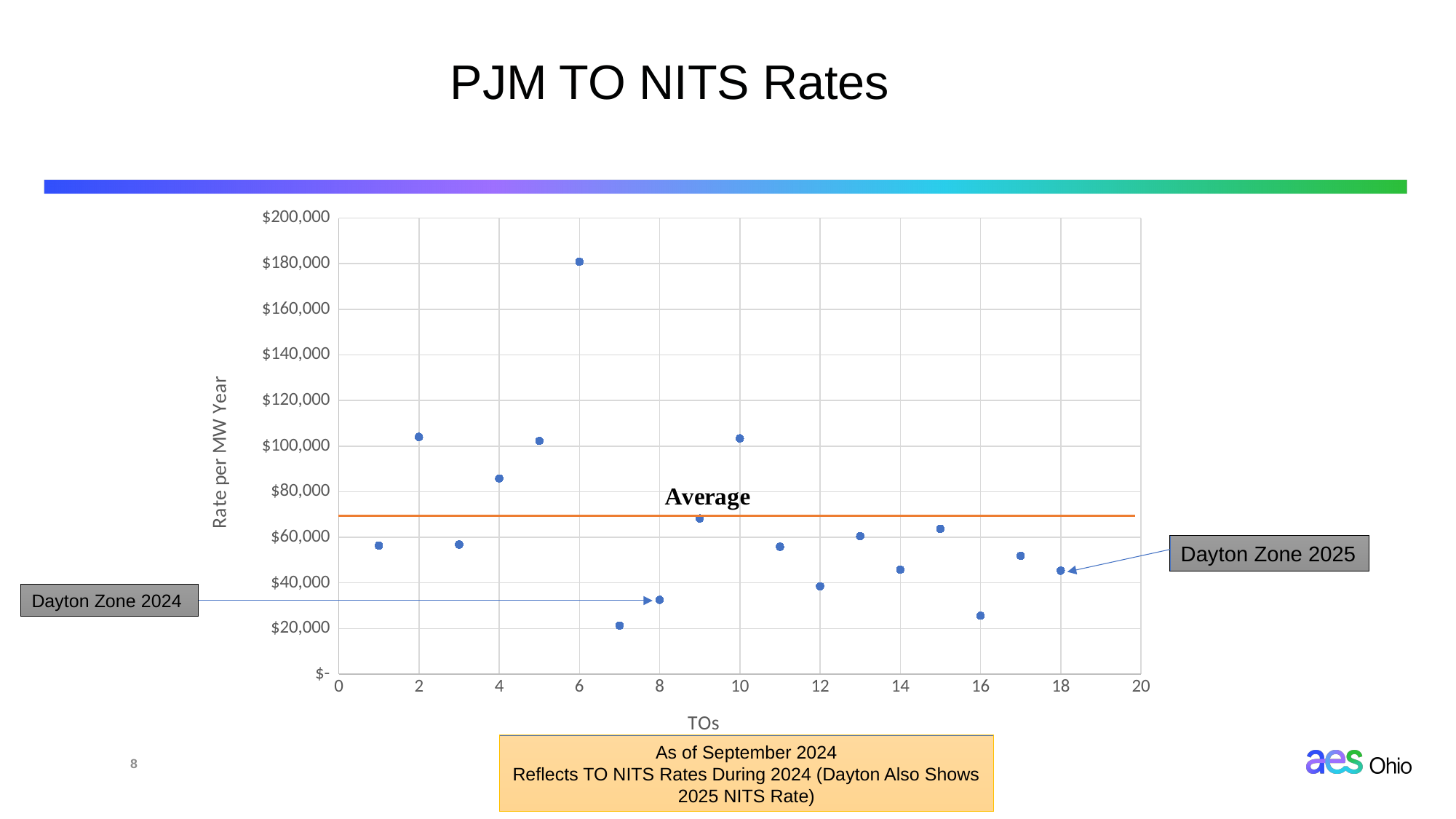
How many data points are plotted on the chart? 18 Which is larger, the value for TO 6 or the value for TO 10? TO 6 Is the value for TO 4 greater or less than $80,000? greater Is the Dayton Zone 2024 value greater or less than $40,000? less What kind of chart is shown on the slide? Scatter chart Is the value for TO 7 greater or less than $40,000? less What is the title of the chart on the slide? PJM TO NITS Rates Which TO (x-axis position) has the highest rate per MW year? 6 Which TO (x-axis position) has the lowest rate per MW year? 7 What is the label of the y-axis? Rate per MW Year Which is larger, the Dayton Zone 2024 value or the Dayton Zone 2025 value? Dayton Zone 2025